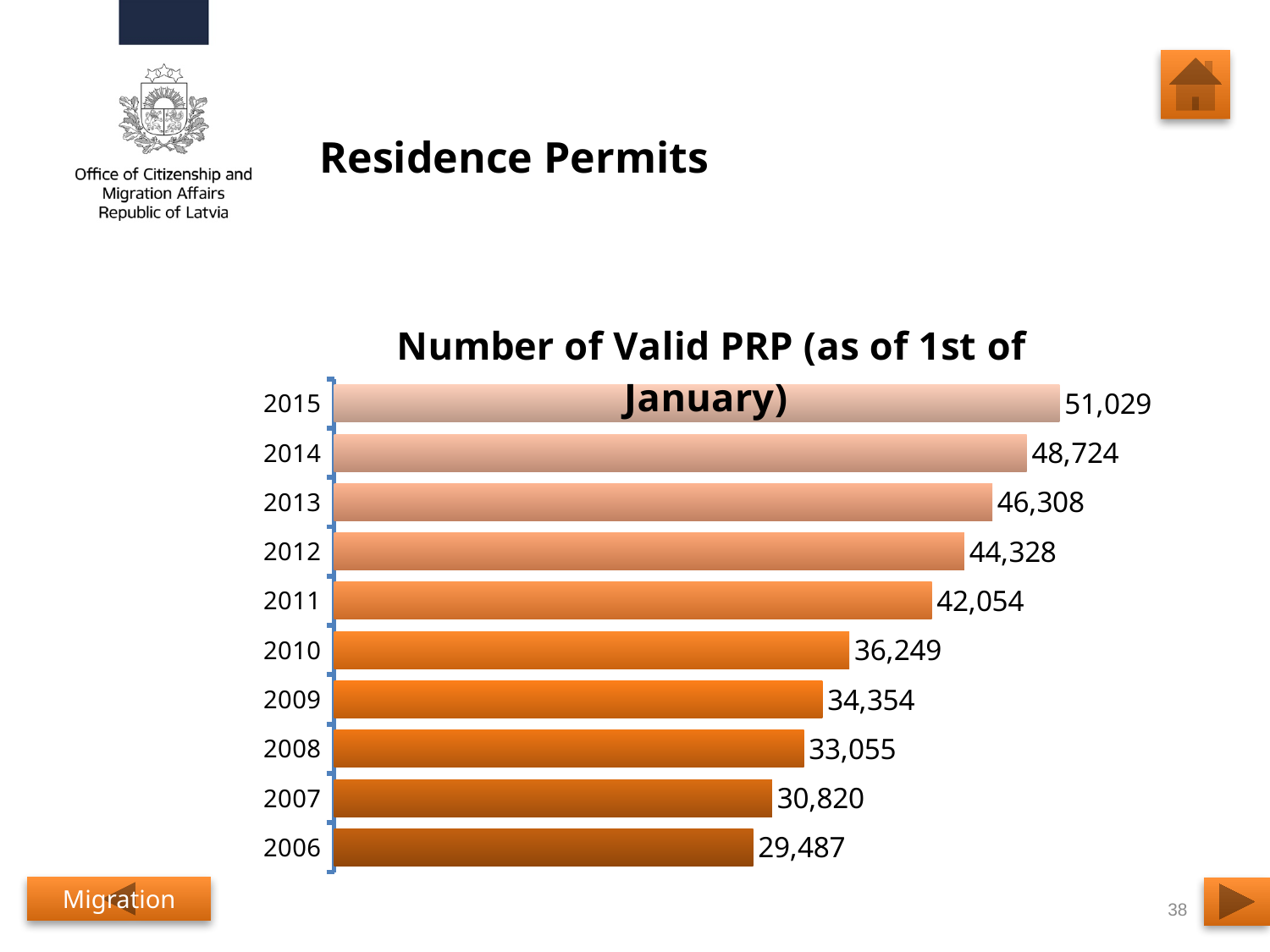
What is the difference between the number of valid PRP in 2011 and in 2010? 5,805 Which year has the highest number of valid PRP? 2015 What is the number of valid PRP as of 1st of January 2006? 29,487 What is the number of valid PRP as of 1st of January 2015? 51,029 What kind of chart is shown on the slide? Bar chart Which year has the lowest number of valid PRP? 2006 What is the title of the chart? Number of Valid PRP (as of 1st of January) How many years are shown in the chart? 10 What is the number of valid PRP as of 1st of January 2010? 36,249 Which year has more valid PRP, 2008 or 2009? 2009 What is the difference between the number of valid PRP in 2015 and in 2014? 2,305 Does the number of valid PRP rise or fall from 2006 to 2015? Rise